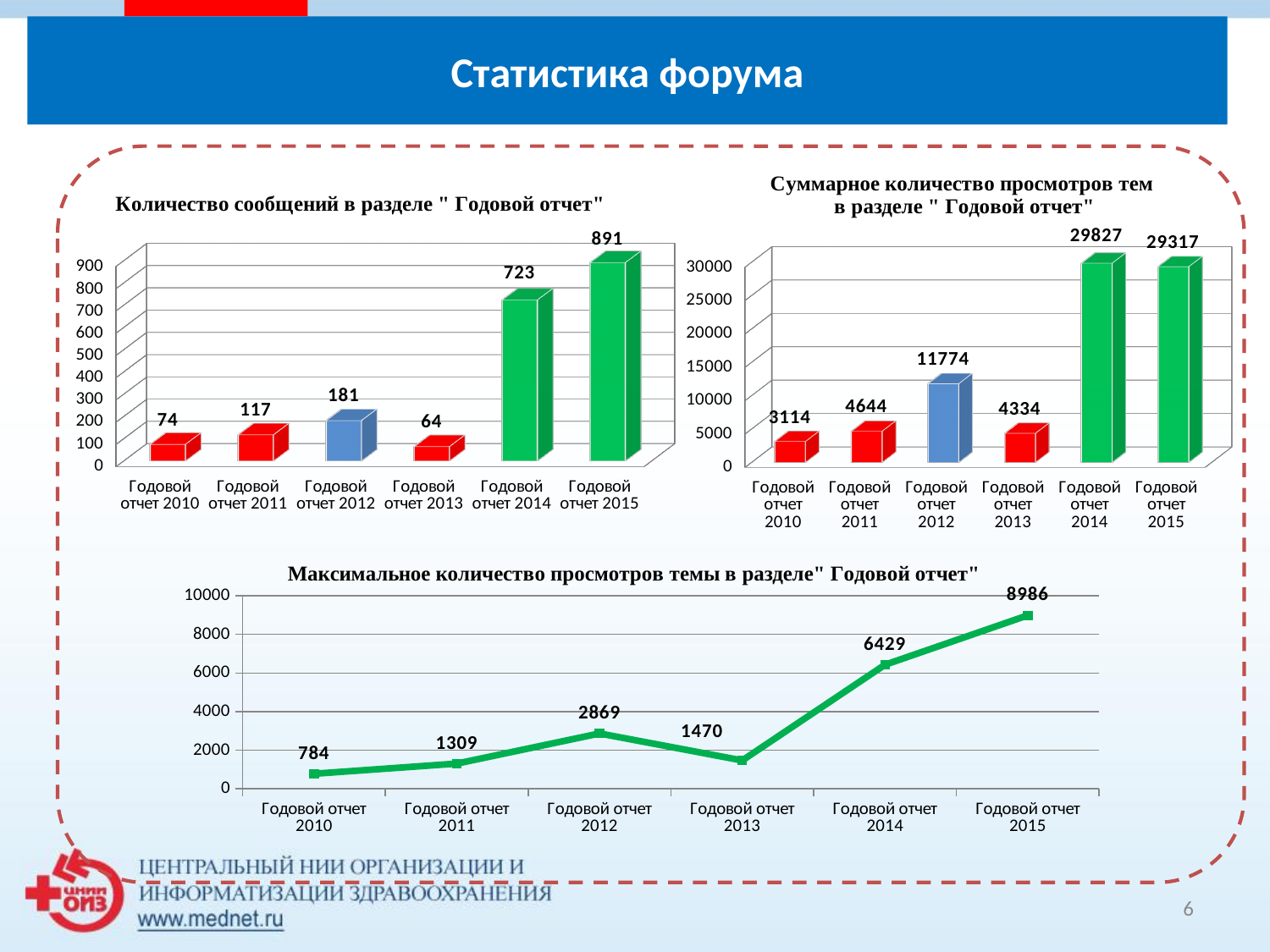
In the top-left chart (Количество сообщений в разделе "Годовой отчет"), what is the difference between Годовой отчет 2015 and Годовой отчет 2014? 168 In the top-left chart (Количество сообщений в разделе "Годовой отчет"), which category has the lowest value? Годовой отчет 2013 How many categories are shown in the top-left chart (Количество сообщений в разделе "Годовой отчет")? 6 In the top-right chart (Суммарное количество просмотров тем), which is larger: Годовой отчет 2011 or Годовой отчет 2013? Годовой отчет 2011 In the bottom chart (Максимальное количество просмотров темы), what is the difference between Годовой отчет 2015 and Годовой отчет 2014? 2557 In the top-left chart (Количество сообщений в разделе "Годовой отчет"), what is the value for Годовой отчет 2014? 723 What kind of chart is the top-right chart (Суммарное количество просмотров тем)? Bar chart In the top-right chart (Суммарное количество просмотров тем), what is the value for Годовой отчет 2012? 11774 In the bottom chart (Максимальное количество просмотров темы), what is the value for Годовой отчет 2012? 2869 In the top-right chart (Суммарное количество просмотров тем), which category has the highest value? Годовой отчет 2014 What kind of chart is the bottom chart (Максимальное количество просмотров темы)? Line chart In the bottom chart (Максимальное количество просмотров темы), does the value rise or fall from Годовой отчет 2013 to Годовой отчет 2015? Rise